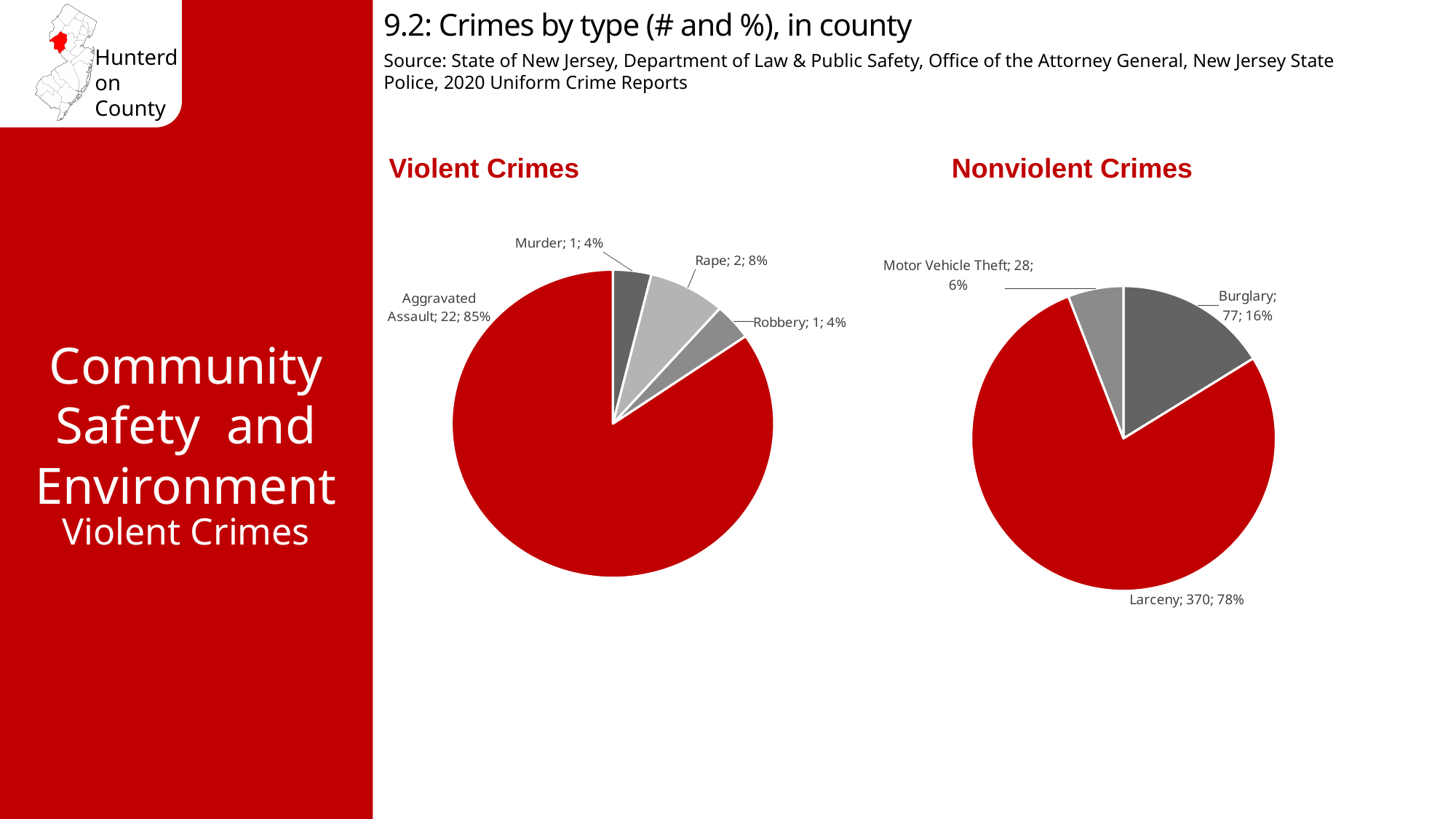
In the Violent Crimes pie chart, which category has the largest slice? Aggravated Assault In the Nonviolent Crimes pie chart, what share of the pie is Burglary? 16% In the Violent Crimes pie chart, how many categories are shown? 4 In the Nonviolent Crimes pie chart, which category has the smallest slice? Motor Vehicle Theft In the Violent Crimes pie chart, how many aggravated assaults are shown? 22 In the Nonviolent Crimes pie chart, what is the difference between the number of burglaries and the number of motor vehicle thefts? 49 In the Nonviolent Crimes pie chart, which is larger, Burglary or Motor Vehicle Theft? Burglary What is the title of the chart on the left? Violent Crimes What kind of chart is used for the Nonviolent Crimes data? Pie chart In the Violent Crimes pie chart, what share of the pie is Rape? 8% In the Violent Crimes pie chart, what is the difference between the number of aggravated assaults and the number of rapes? 20 In the Nonviolent Crimes pie chart, how many larcenies are shown? 370